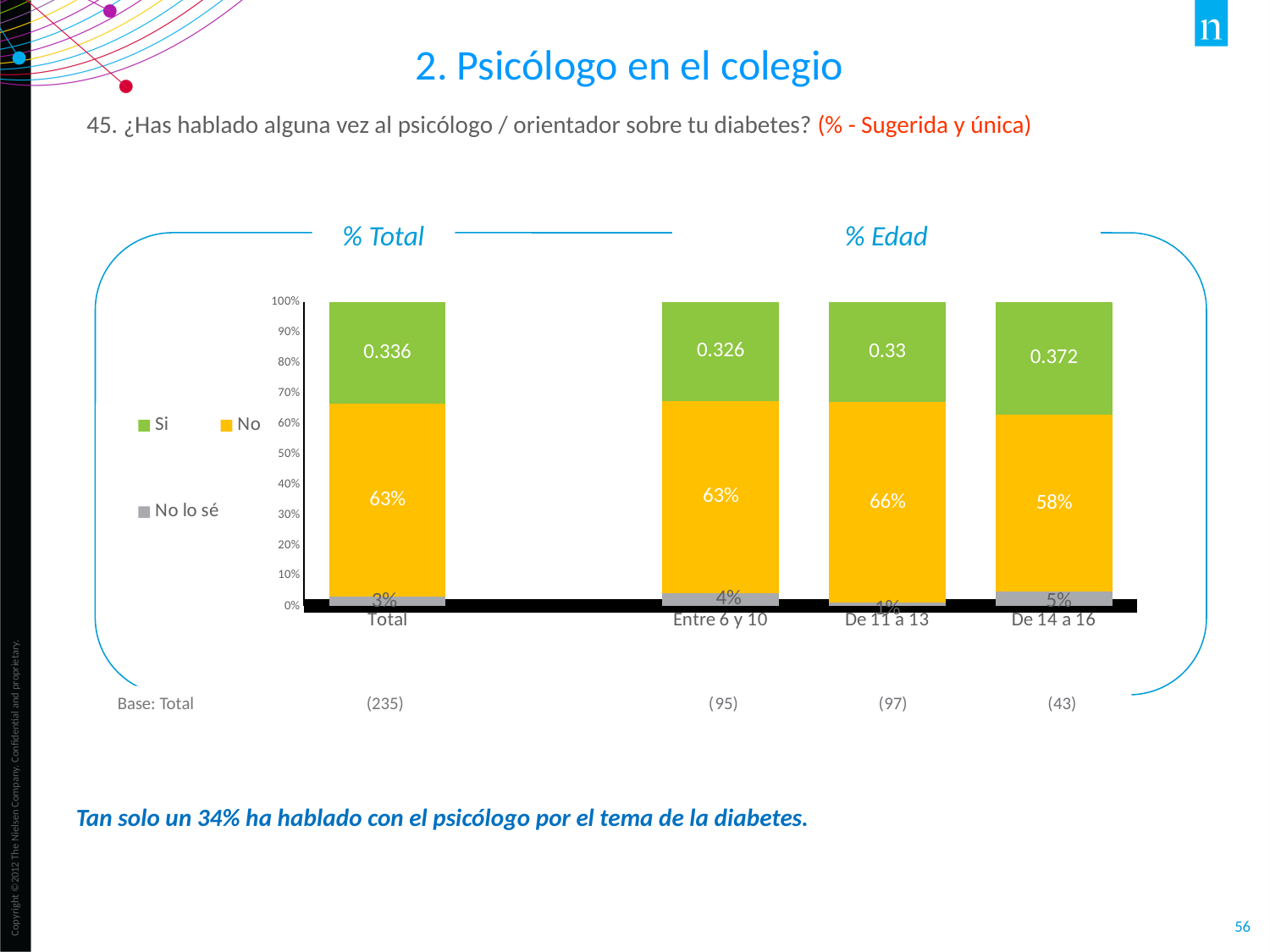
How many categories are shown on the x axis of the chart? 4 What is the difference between the "No" values for "De 11 a 13" and "De 14 a 16"? 8% Which category has the highest value for the "Si" series? De 14 a 16 Which category has the lowest value for the "No" series? De 14 a 16 How many series does the legend list? 3 Which category has the highest value for the "No" series? De 11 a 13 What kind of chart is shown on the slide? Stacked bar chart What is the value of the "No lo sé" series for the "Entre 6 y 10" category? 4% Which is larger: the "No lo sé" value for "De 14 a 16" or for "Total"? De 14 a 16 What is the value of the "No" series for the "Total" category? 63% What is the value of the "Si" series for the "De 14 a 16" category? 0.372 What is the value of the "Si" series for the "Entre 6 y 10" category? 0.326